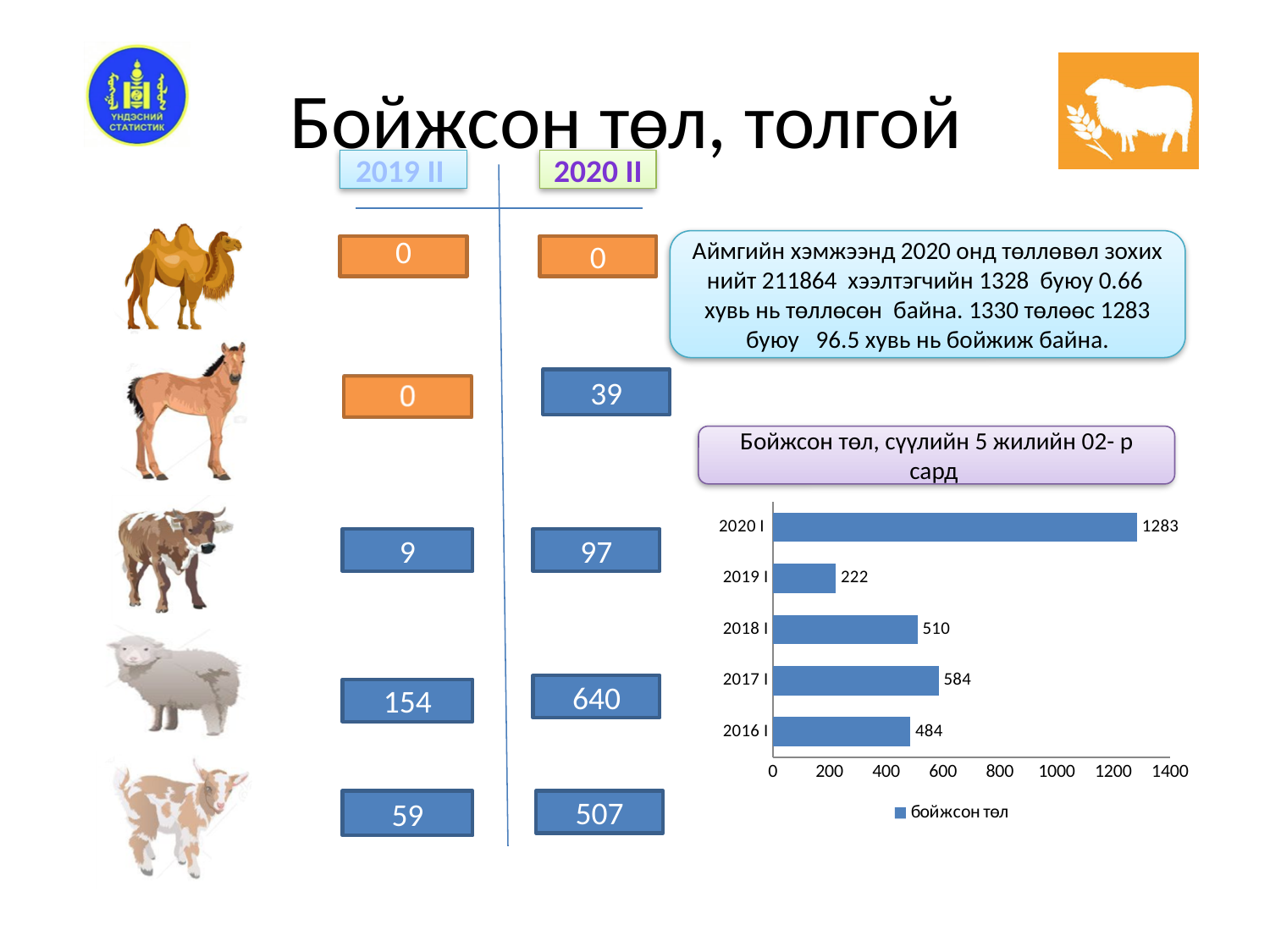
What is the value for 2016 I in the bar chart? 484 What is the difference between the values for 2017 I and 2018 I in the bar chart? 74 What is the difference between the values for 2020 I and 2019 I in the bar chart? 1061 How many categories are shown in the bar chart? 5 What is the legend entry of the bar chart? бойжсон төл Which category has the lowest value in the bar chart? 2019 I What is the value for 2019 I in the bar chart? 222 What is the value for 2020 I in the bar chart? 1283 What kind of chart is shown on the slide? bar chart What is the value for 2017 I in the bar chart? 584 Which category has the highest value in the bar chart? 2020 I Which is larger in the bar chart, the value for 2018 I or the value for 2016 I? 2018 I